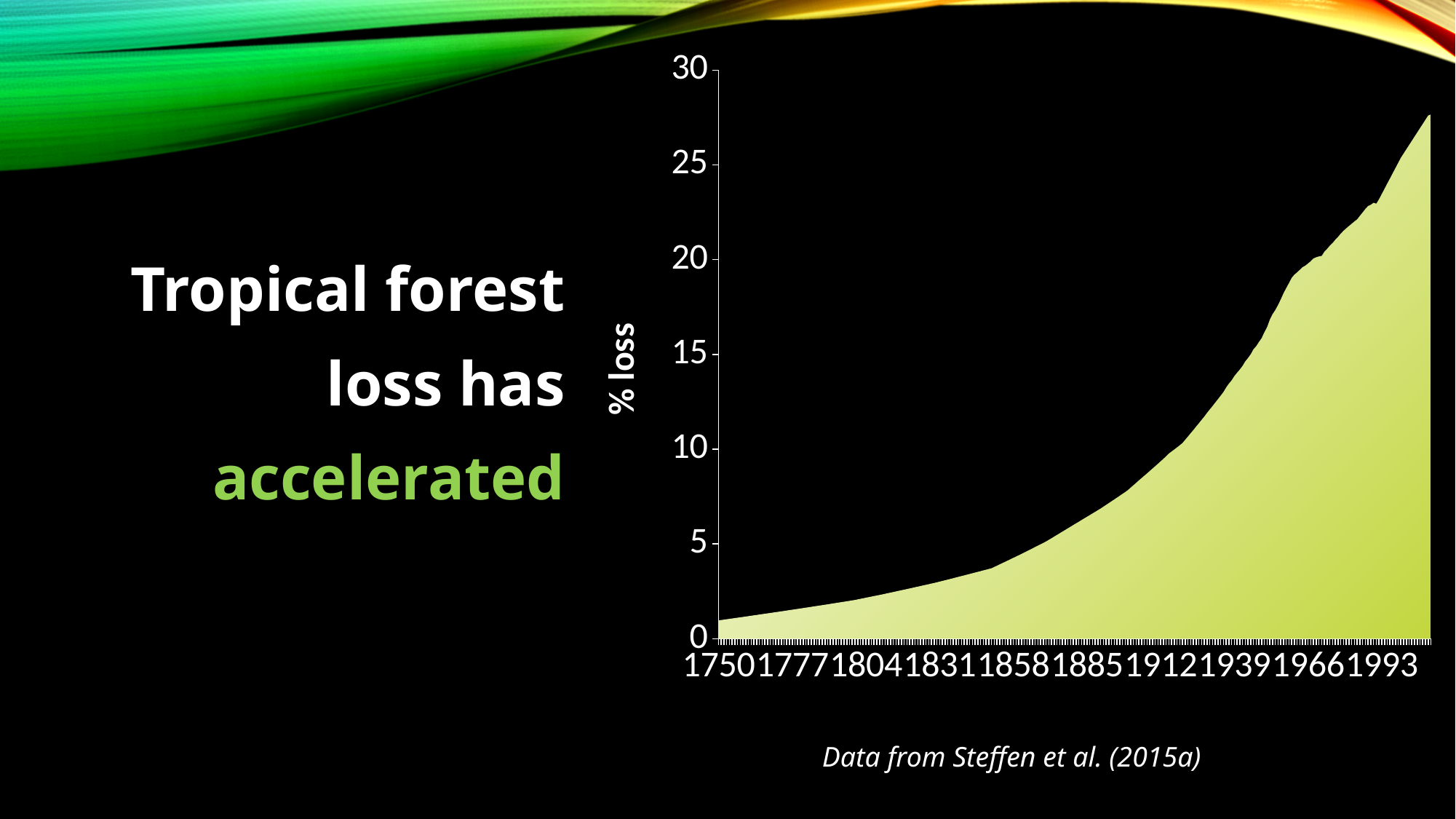
Is the % loss value for 1993 greater or less than 20? greater Do the % loss values rise or fall from 1750 to the end of the x axis? rise What kind of chart is shown on the slide? area chart What is the label on the y axis of the chart? % loss How many year labels are shown on the x axis? 10 Is the % loss value for 1858 greater or less than 5? less Is the % loss value for 1939 greater or less than 10? greater What is the highest tick value shown on the y axis? 30